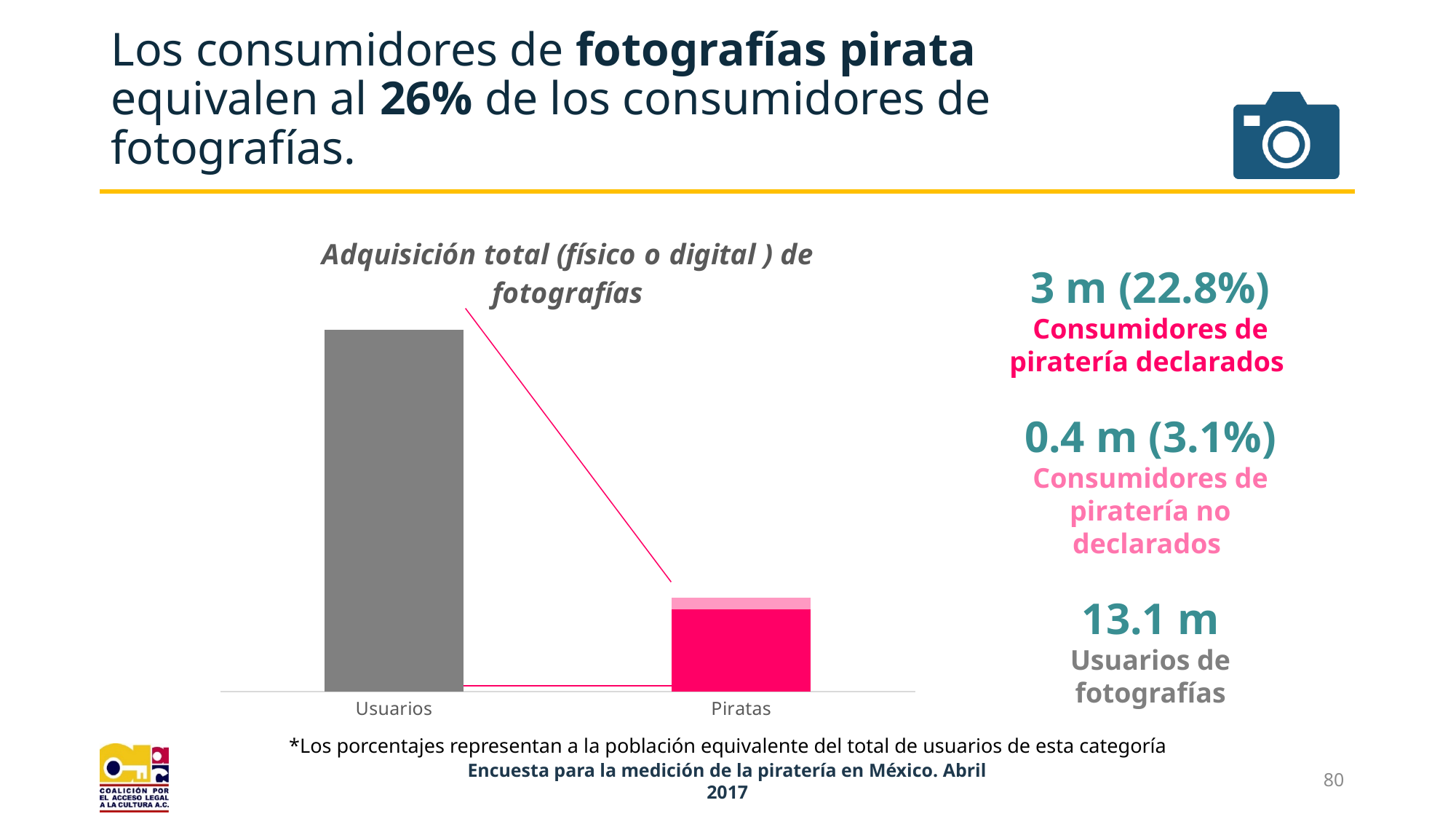
How many categories are shown on the x axis of the chart? 2 What kind of chart is shown on the slide? bar chart Which category has the tallest bar in the chart? Usuarios According to the annotation on the slide, what is the value for undeclared piracy consumers (Consumidores de piratería no declarados)? 0.4 m (3.1%) According to the annotation on the slide, how many users of photographs (Usuarios de fotografías) are there? 13.1 m What percentage of photograph consumers do declared piracy consumers represent, according to the annotation? 22.8% Which category has the shortest bar in the chart? Piratas What is the title of the chart? Adquisición total (físico o digital ) de fotografías What colour is the Usuarios bar in the chart? gray Using the annotated values, what is the total of the stacked Piratas bar (declared plus undeclared piracy consumers)? 3.4 m Is the bar for Usuarios taller or shorter than the bar for Piratas? taller According to the annotation on the slide, what is the value for declared piracy consumers (Consumidores de piratería declarados)? 3 m (22.8%)